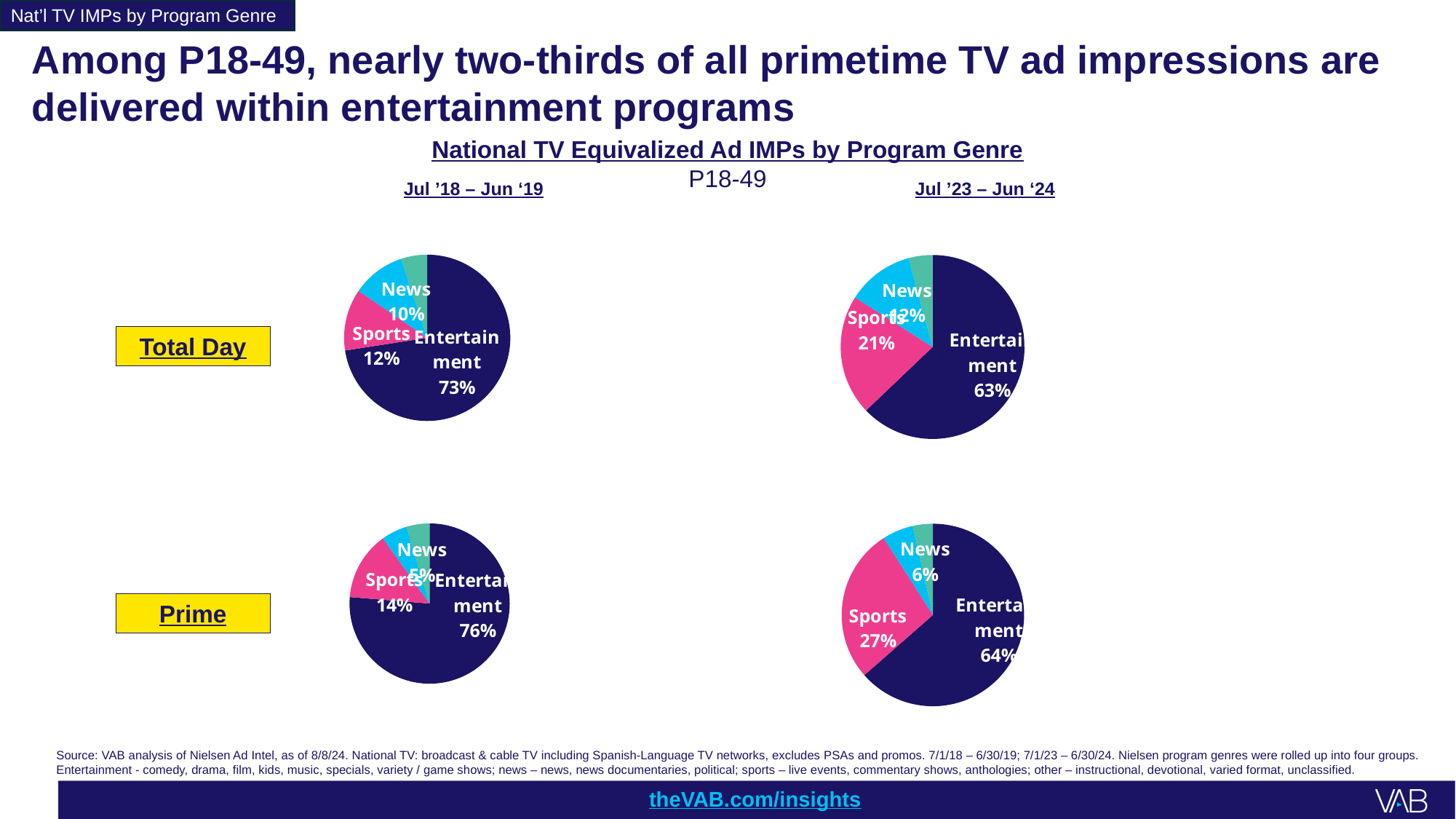
How many slices does the Prime pie chart for Jul '18 – Jun '19 contain? 4 How much larger is the Sports share in the Prime pie chart for Jul '23 – Jun '24 than in the Prime pie chart for Jul '18 – Jun '19? 13 percentage points In the Prime pie chart for Jul '23 – Jun '24, what share of ad impressions is delivered within Entertainment programs? 64% What type of chart is used to show the ad impressions by program genre on this slide? Pie chart In the Total Day pie chart for Jul '18 – Jun '19, which labeled genre has the smallest share? News In the Prime pie chart for Jul '23 – Jun '24, which labeled genre has the largest share? Entertainment By how many percentage points did the Entertainment share in the Total Day pie chart fall from Jul '18 – Jun '19 to Jul '23 – Jun '24? 10 percentage points Which is larger: the News share in the Total Day pie chart for Jul '23 – Jun '24 or the News share in the Prime pie chart for Jul '23 – Jun '24? Total Day (12%) In the Prime pie chart for Jul '18 – Jun '19, what share of ad impressions is delivered within News programs? 5% What is the title of the chart group on this slide? National TV Equivalized Ad IMPs by Program Genre In the Total Day pie chart for Jul '18 – Jun '19, what share of ad impressions is delivered within Entertainment programs? 73% In the Total Day pie chart for Jul '23 – Jun '24, what share of ad impressions is delivered within Sports programs? 21%